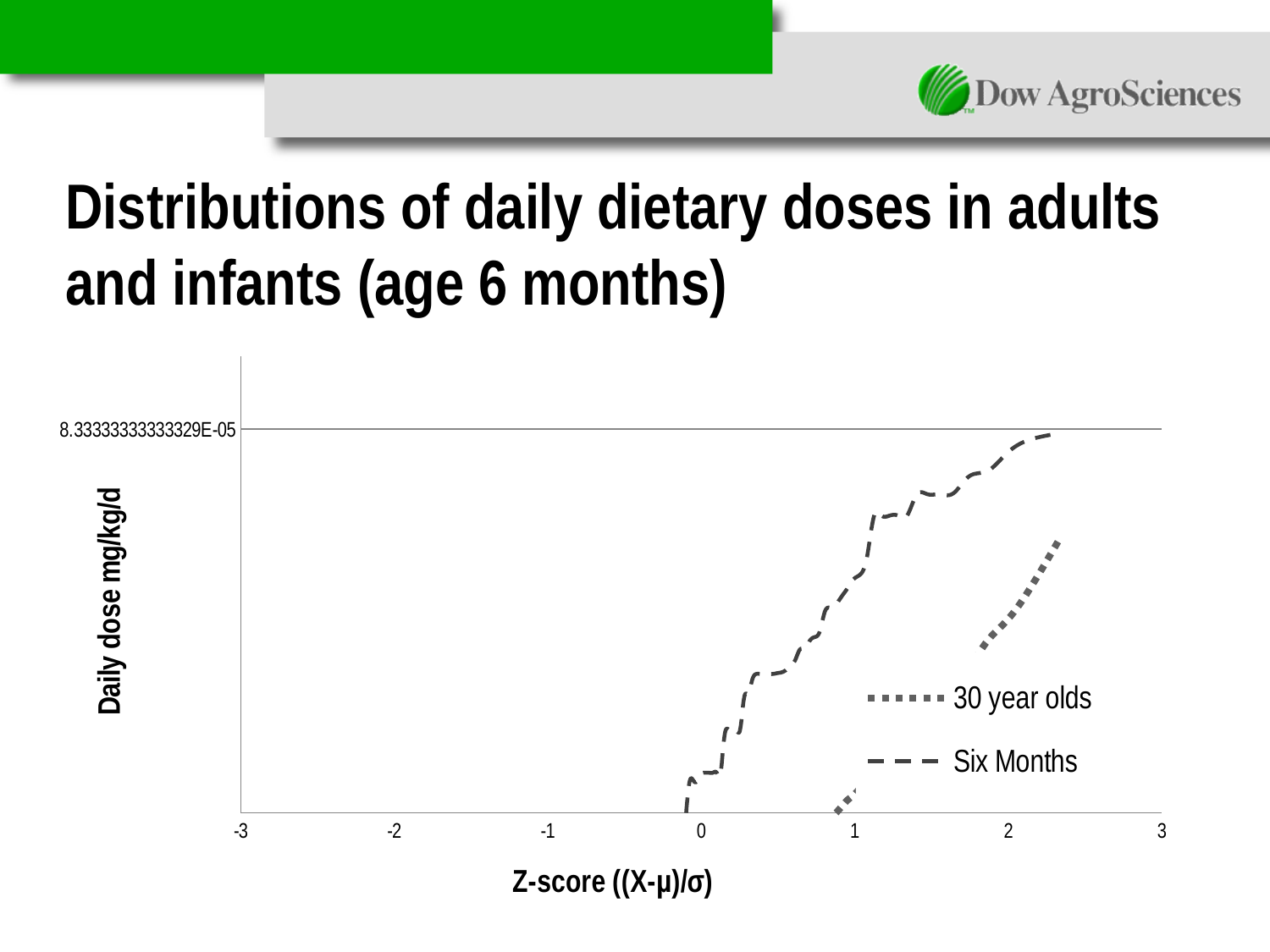
At a Z-score of 2, which series has the higher daily dose, 30 year olds or Six Months? Six Months What kind of chart is shown on the slide? line chart Does the 30 year olds line rise or fall as the Z-score increases? rise Does the Six Months line rise or fall as the Z-score increases? rise What is the highest Z-score value shown on the x axis? 3 What are the two series named in the legend? 30 year olds and Six Months What is the title of the chart's x axis? Z-score ((X-μ)/σ) What is the lowest Z-score value shown on the x axis? -3 Is the Six Months value at a Z-score of 1 greater or less than 8.33333333333329E-05? less Which series reaches the higher daily dose at the right end of its line? Six Months How many tick labels are shown on the x axis? 7 How many series does the legend list? 2